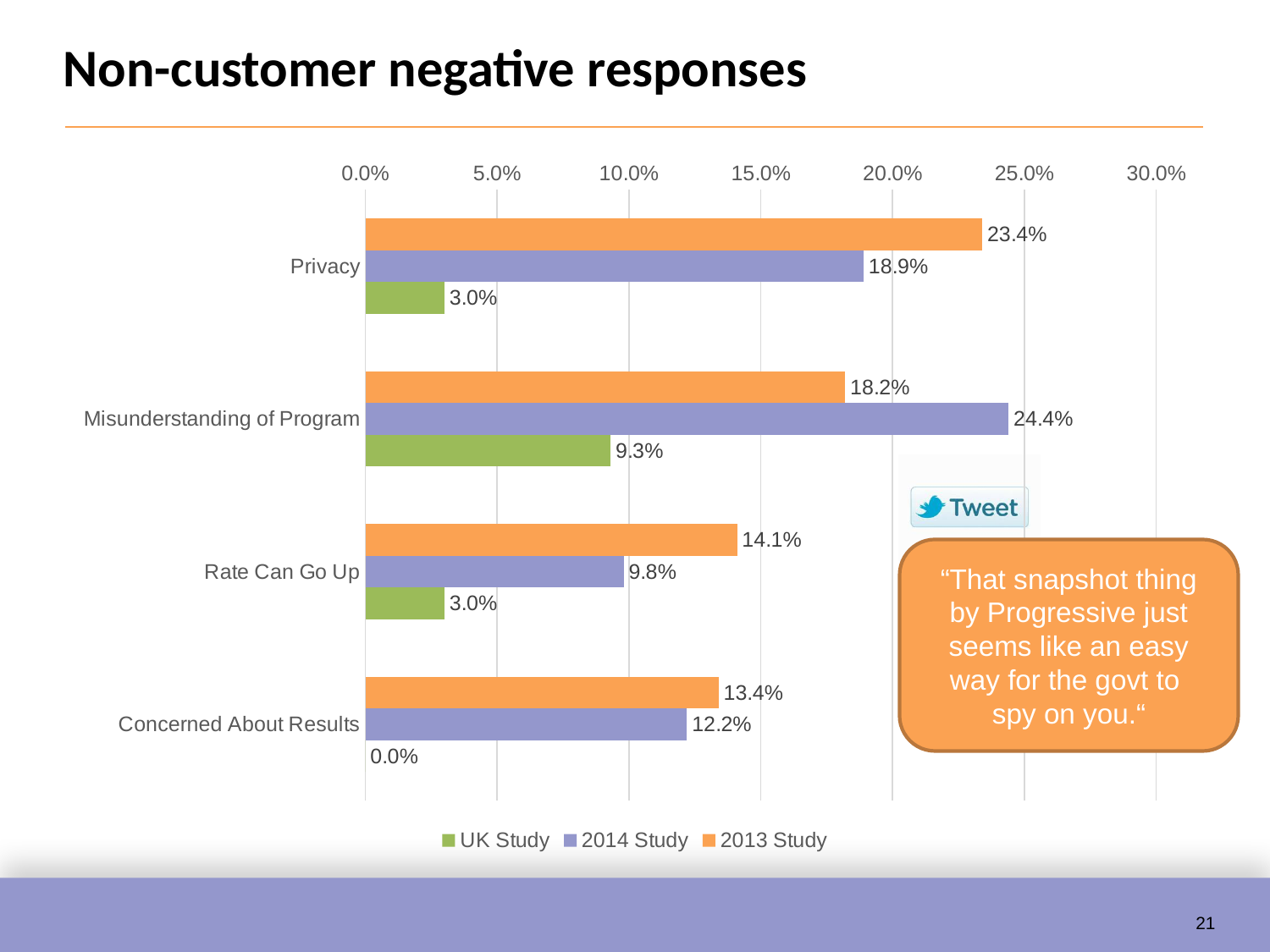
What is the UK Study value for Concerned About Results? 0.0% Which category has the highest 2014 Study value? Misunderstanding of Program Which category has the lowest 2013 Study value? Concerned About Results What is the 2013 Study value for Privacy? 23.4% Which series is shown in green in the legend? UK Study How many categories are shown on the chart? 4 What kind of chart is shown on the slide? Bar chart What is the 2014 Study value for Misunderstanding of Program? 24.4% How many series does the legend list? 3 What is the difference between the 2013 Study and 2014 Study values for Privacy? 4.5% Is the 2014 Study value for Misunderstanding of Program greater or less than 20.0%? greater For Rate Can Go Up, which is larger: the 2013 Study value or the 2014 Study value? 2013 Study